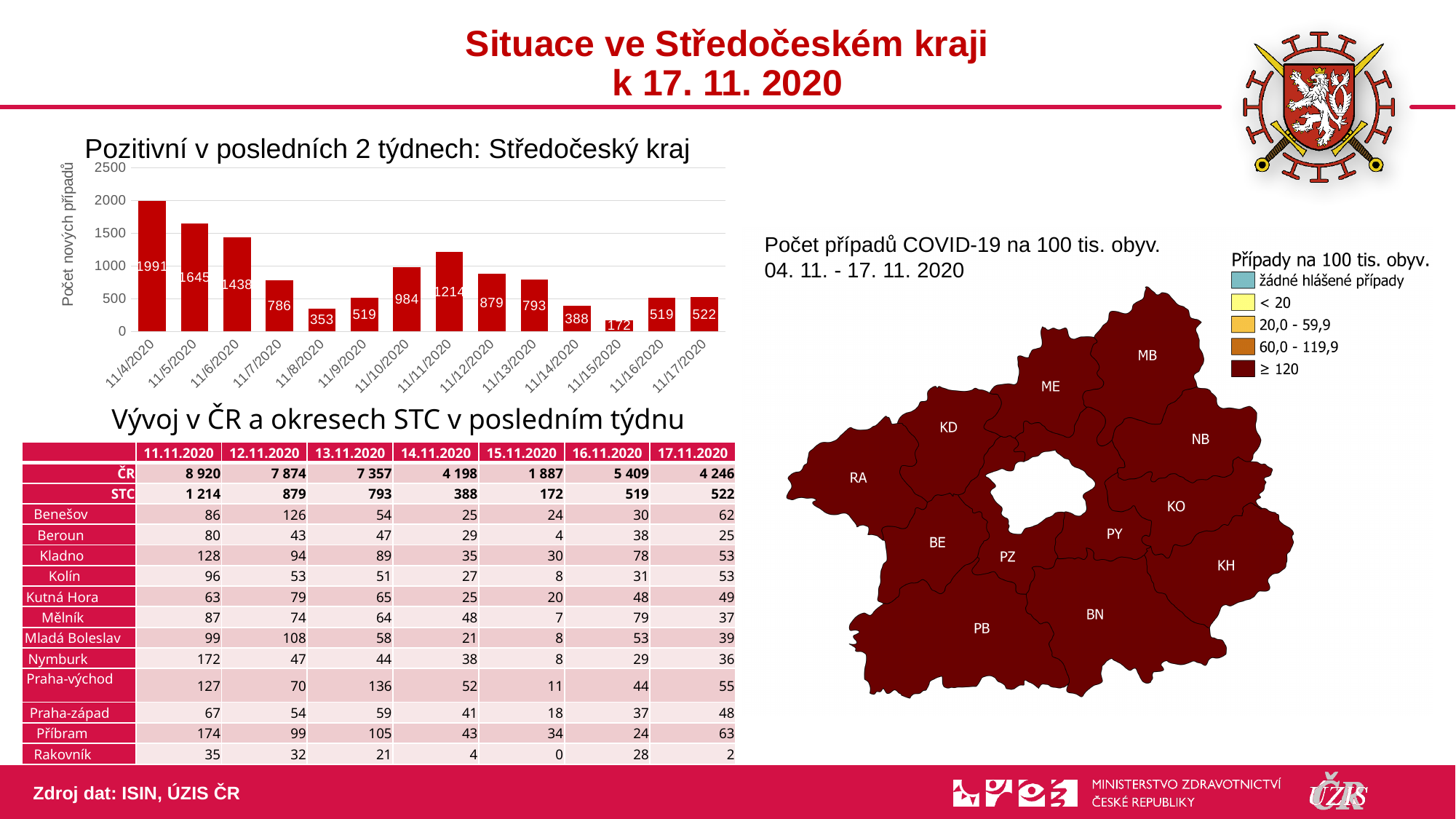
In the bar chart, what is the value for 11/4/2020? 1991 What is the y-axis label of the bar chart? Počet nových případů How many dates (bars) are shown in the bar chart? 14 In the bar chart, which date has the lowest number of new cases? 11/15/2020 In the bar chart, is the value for 11/7/2020 greater or less than 1000? less In the bar chart, what is the value for 11/11/2020? 1214 In the bar chart, which is larger: the value for 11/10/2020 or the value for 11/12/2020? 11/10/2020 In the bar chart, which date has the highest number of new cases? 11/4/2020 What type of chart is 'Pozitivní v posledních 2 týdnech: Středočeský kraj'? bar chart In the bar chart, do the values rise or fall from 11/4/2020 to 11/8/2020? fall In the bar chart, what is the value for 11/15/2020? 172 In the bar chart, what is the difference between the values for 11/4/2020 and 11/5/2020? 346